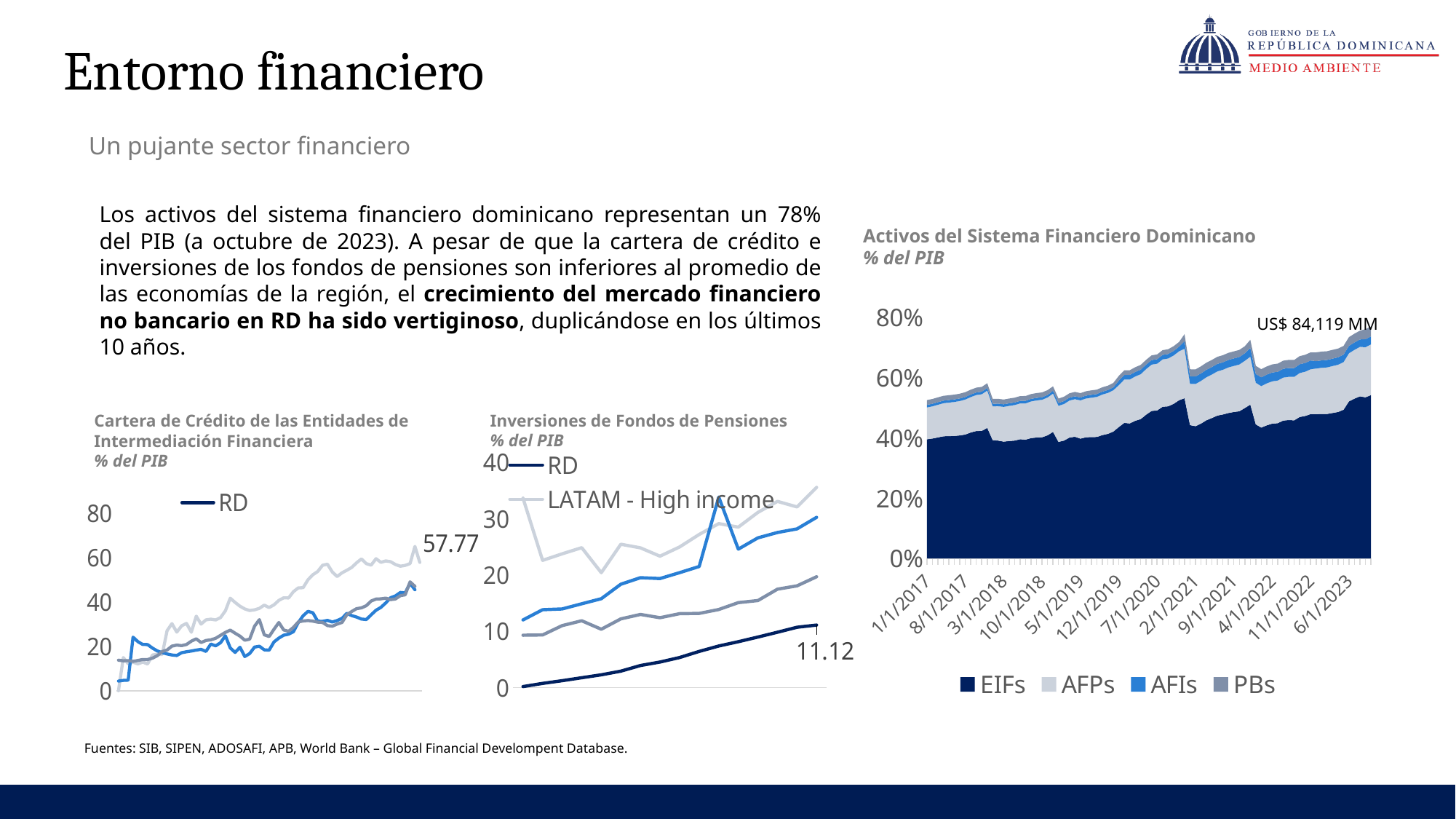
In the 'Inversiones de Fondos de Pensiones' chart, what is the final labelled value of the RD series? 11.12 What value annotation is shown at the end of the 'Activos del Sistema Financiero Dominicano' chart? US$ 84,119 MM What kind of chart is the 'Inversiones de Fondos de Pensiones' chart? Line chart In the 'Cartera de Crédito de las Entidades de Intermediación Financiera' chart, what is the data label shown at the end of the series? 57.77 What kind of chart is the 'Activos del Sistema Financiero Dominicano' chart? Stacked area chart In the 'Inversiones de Fondos de Pensiones' chart, does the RD series rise or fall over time? rise In the 'Activos del Sistema Financiero Dominicano' chart, is the EIFs value at the end of the series greater or less than 40%? greater In the 'Activos del Sistema Financiero Dominicano' chart, is the total of all series at the end greater or less than 60%? greater In the 'Activos del Sistema Financiero Dominicano' chart, which series accounts for the largest share of assets? EIFs How many series does the legend of the 'Inversiones de Fondos de Pensiones' chart list? 2 What are the legend entries of the 'Activos del Sistema Financiero Dominicano' chart? EIFs, AFPs, AFIs, PBs How many series does the legend of the 'Activos del Sistema Financiero Dominicano' chart list? 4